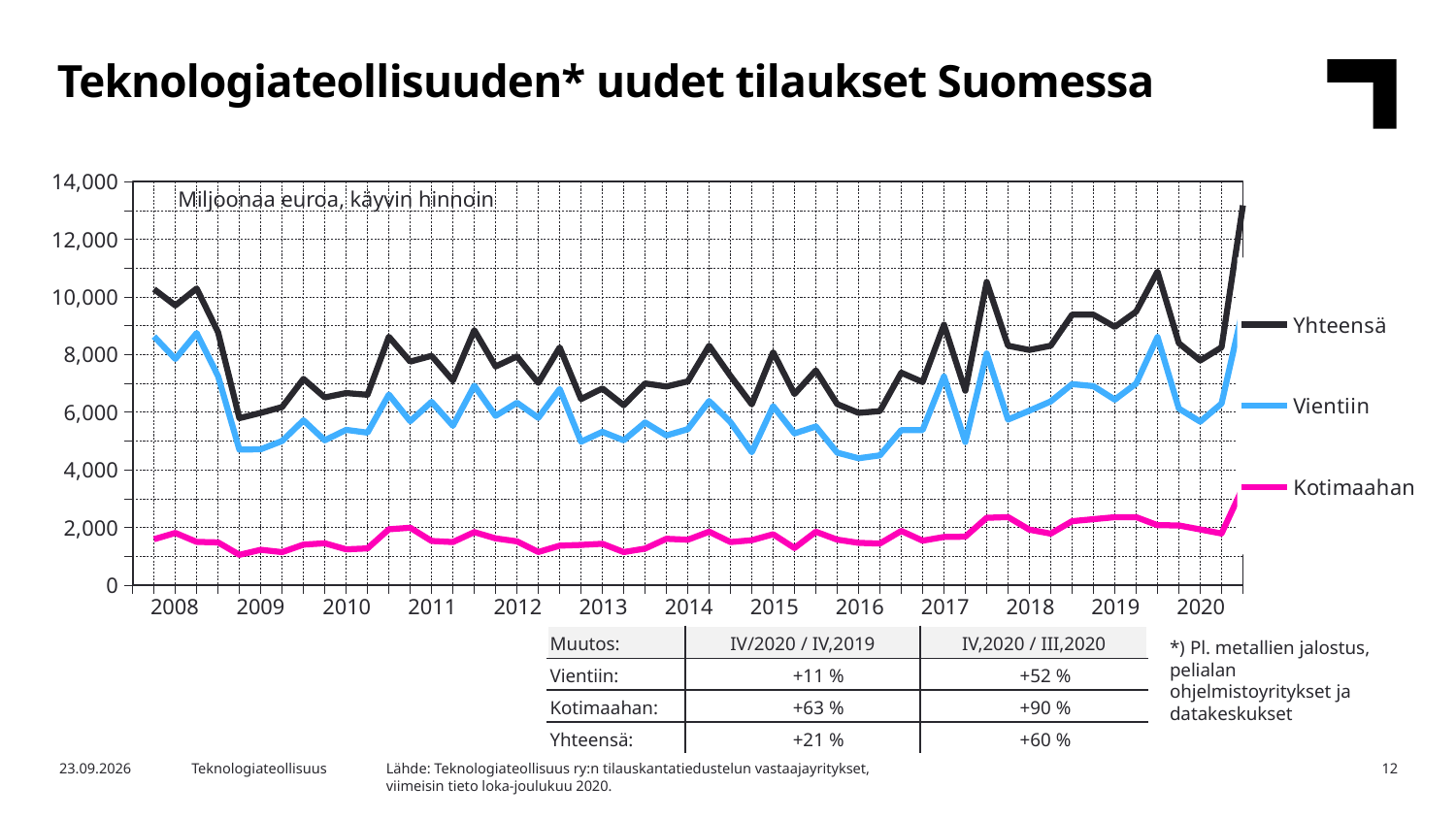
What are the three series named in the legend? Yhteensä, Vientiin, Kotimaahan Is the value for Vientiin at the last point of 2020 greater or less than 8,000? greater Which is larger at the start of 2008, Vientiin or Kotimaahan? Vientiin Is the value for Kotimaahan at the last point of 2020 greater or less than 4,000? less Is the value for Yhteensä at the last point of 2020 greater or less than 12,000? greater Which series has the lowest values throughout the chart? Kotimaahan What kind of chart is shown on the slide? Line chart How many year labels are shown on the x axis? 13 Which series has the highest values throughout the chart? Yhteensä Does the Yhteensä line rise or fall from the start of 2008 to the start of 2009? fall What is the title of the chart? Teknologiateollisuuden* uudet tilaukset Suomessa How many series does the legend list? 3